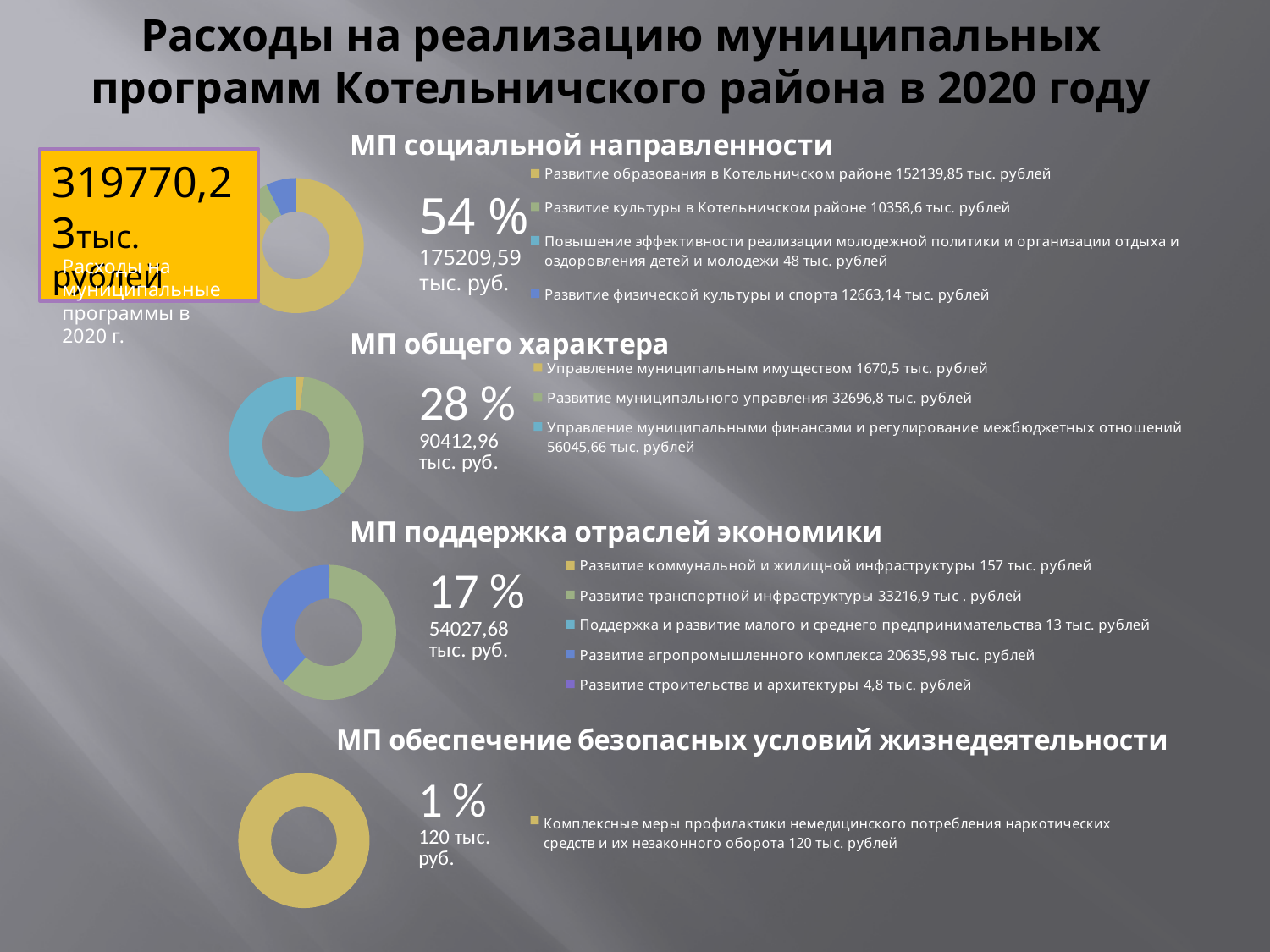
On the chart 'МП поддержка отраслей экономики', what is the value for 'Развитие агропромышленного комплекса'? 20635,98 тыс. рублей On the chart 'МП поддержка отраслей экономики', what is the difference between 'Развитие коммунальной и жилищной инфраструктуры' and 'Поддержка и развитие малого и среднего предпринимательства'? 144 тыс. рублей What type of chart is used for 'МП социальной направленности'? Doughnut chart On the chart 'МП общего характера', what is the value for 'Развитие муниципального управления'? 32696,8 тыс. рублей On the chart 'МП общего характера', which category has the highest value? Управление муниципальными финансами и регулирование межбюджетных отношений On the chart 'МП социальной направленности', what is the value for 'Развитие образования в Котельничском районе'? 152139,85 тыс. рублей On the chart 'МП общего характера', what share of total expenditure does this group of programs represent? 28 % On the chart 'МП социальной направленности', how many categories does the legend list? 4 On the chart 'МП поддержка отраслей экономики', how many categories does the legend list? 5 On the chart 'МП поддержка отраслей экономики', which is larger: 'Развитие транспортной инфраструктуры' or 'Развитие агропромышленного комплекса'? Развитие транспортной инфраструктуры On the chart 'МП социальной направленности', which category has the lowest value? Повышение эффективности реализации молодежной политики и организации отдыха и оздоровления детей и молодежи On the chart 'МП обеспечение безопасных условий жизнедеятельности', what is the value for 'Комплексные меры профилактики немедицинского потребления наркотических средств и их незаконного оборота'? 120 тыс. рублей